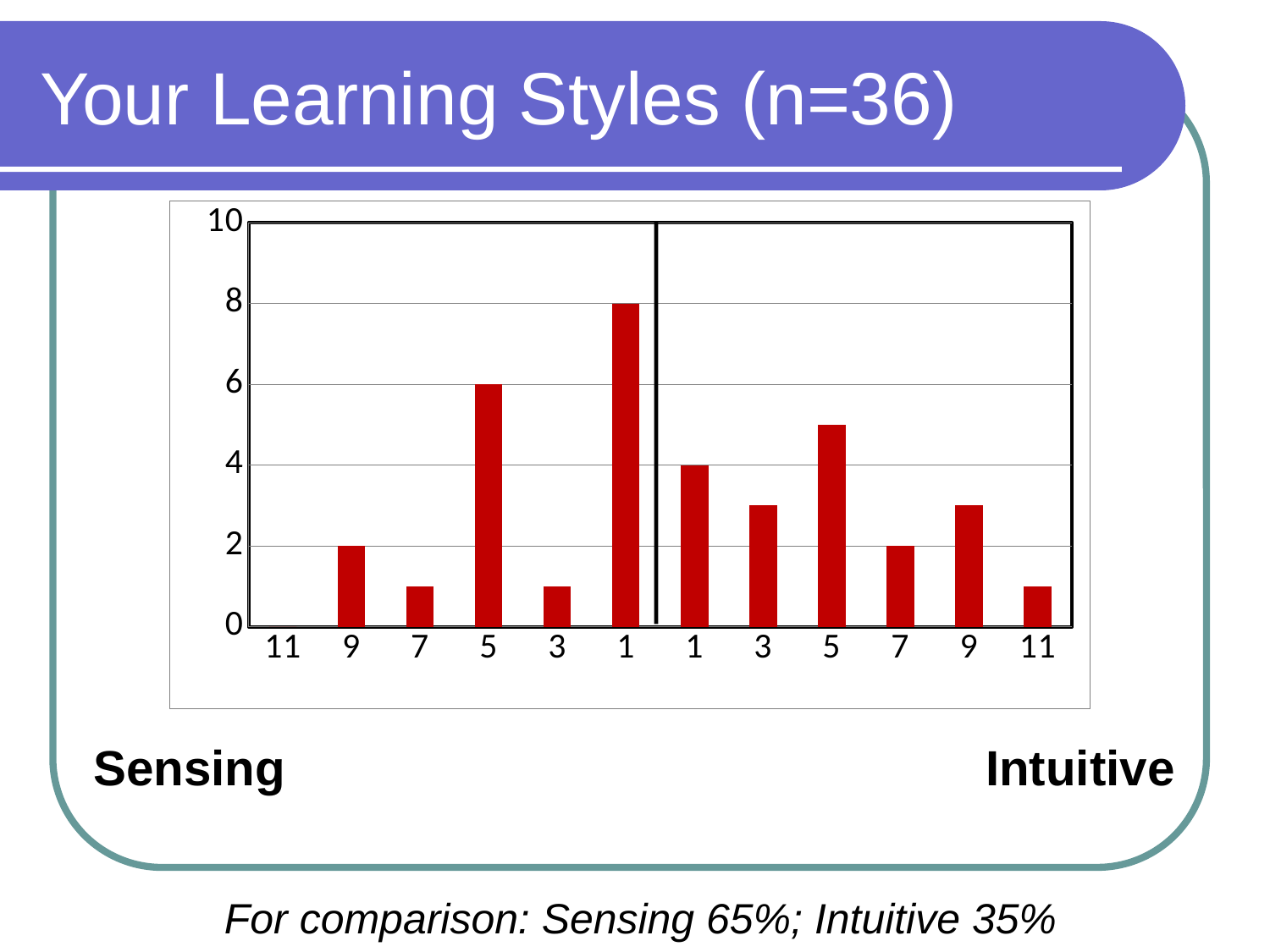
What is the value of the bar at 5 on the Sensing side? 6 Which is larger: the bar at 1 on the Sensing side or the bar at 5 on the Intuitive side? 1 on the Sensing side Is the value of the bar at 5 on the Intuitive side greater or less than 4? greater What is the value of the bar at 9 on the Sensing side? 2 How many bars (categories) are plotted along the x axis? 12 What is the value of the bar at 1 on the Intuitive side? 4 What is the value of the bar at 1 on the Sensing side? 8 What is the title of the slide's chart? Your Learning Styles (n=36) What is the value of the bar at 7 on the Intuitive side? 2 What is the difference between the bar at 1 on the Sensing side and the bar at 5 on the Sensing side? 2 What type of chart is shown on the slide? bar chart Which category has the tallest bar? 1 on the Sensing side